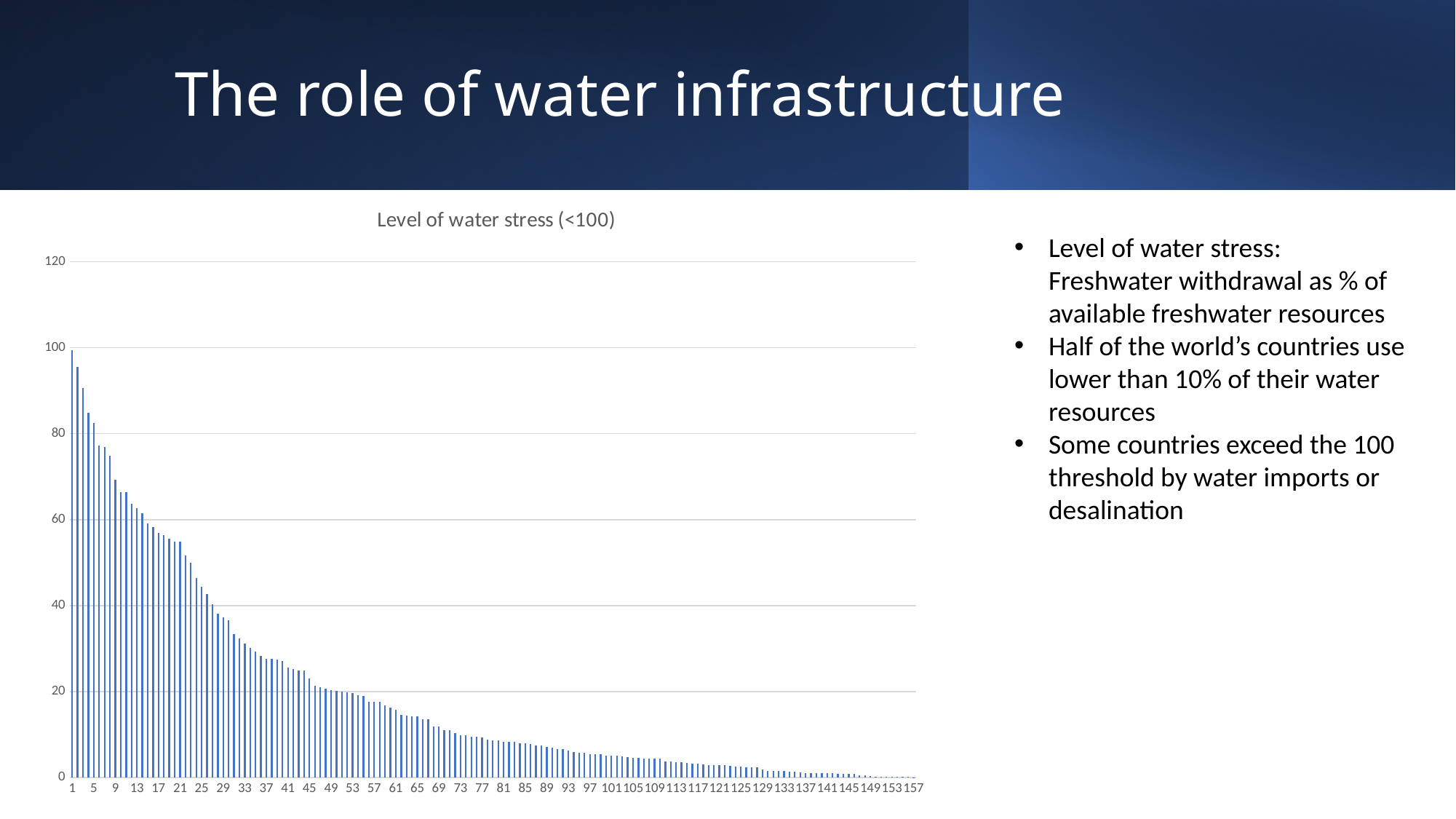
Is the value for category 1 greater or less than 80? greater Which has the larger value, category 5 or category 45? category 5 Is the value for category 41 greater or less than 40? less What is the title of the chart? Level of water stress (<100) What is the highest value shown on the y axis? 120 Is the value for category 9 greater or less than 60? greater Which category has the highest value in the chart? 1 What kind of chart is shown on the slide? bar chart Do the values rise or fall as you move from left to right along the x axis? fall